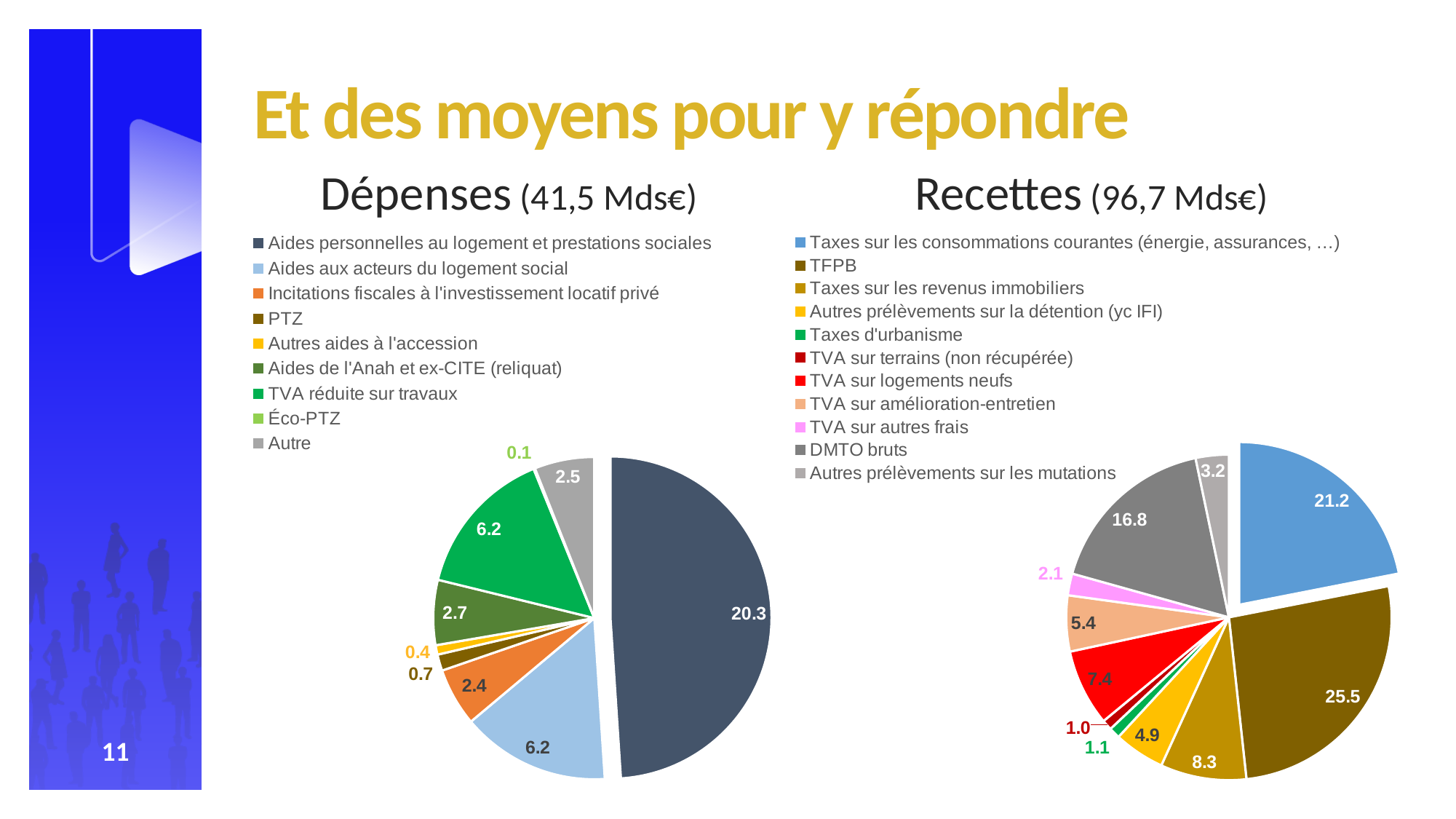
On the Recettes chart, what is the value for DMTO bruts? 16.8 What total is shown in the title of the Recettes chart? 96,7 Mds€ What kind of chart is the Dépenses chart? Pie chart On the Dépenses chart, what is the value for Aides personnelles au logement et prestations sociales? 20.3 On the Recettes chart, what is the value for TVA sur logements neufs? 7.4 On the Recettes chart, which category has the largest value? TFPB How many categories does the Recettes chart's legend list? 11 On the Dépenses chart, what is the difference between TVA réduite sur travaux and Autre? 3.7 On the Dépenses chart, which category has the smallest value? Éco-PTZ How many categories does the Dépenses chart's legend list? 9 On the Dépenses chart, which is larger: Aides de l'Anah et ex-CITE (reliquat) or Incitations fiscales à l'investissement locatif privé? Aides de l'Anah et ex-CITE (reliquat) On the Recettes chart, what is the difference between TFPB and Taxes sur les consommations courantes? 4.3